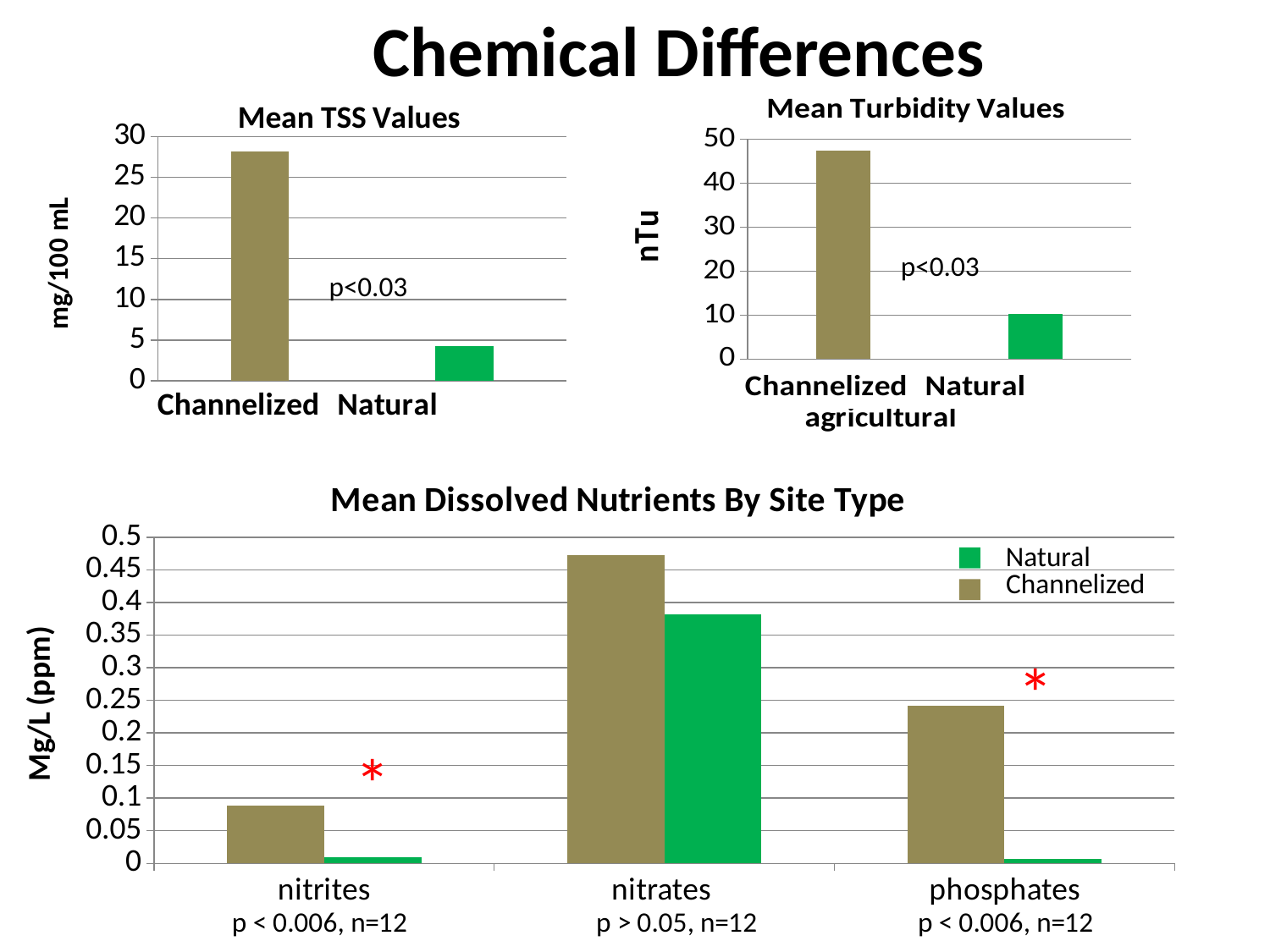
In the Mean TSS Values chart, is the value for Channelized greater or less than 25? greater In the Mean TSS Values chart, which category has the higher value, Channelized or Natural? Channelized In the Mean Dissolved Nutrients By Site Type chart, is the Natural value for nitrates greater or less than 0.4? less In the Mean Dissolved Nutrients By Site Type chart, is the Channelized value for nitrates greater or less than 0.45? greater What is the y-axis label of the Mean Turbidity Values chart? nTu In the Mean Dissolved Nutrients By Site Type chart, how many nutrient categories are shown on the x axis? 3 What kind of chart is the Mean Dissolved Nutrients By Site Type chart? bar chart In the Mean Dissolved Nutrients By Site Type chart, which nutrient has the highest Channelized value? nitrates In the Mean Turbidity Values chart, which category has the lowest value? Natural In the Mean Dissolved Nutrients By Site Type chart, how many series does the legend list? 2